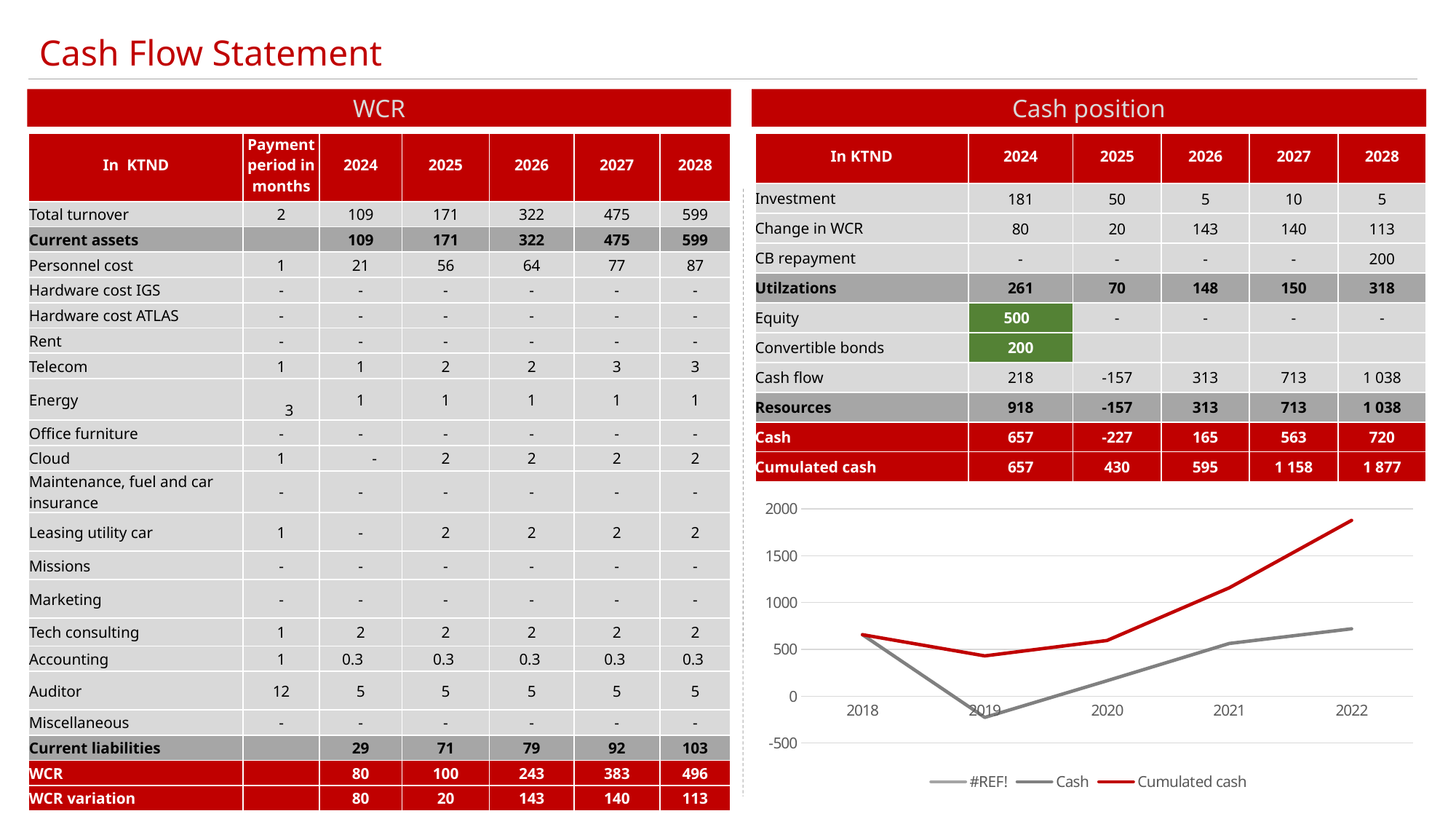
Which entries appear in the legend of the line chart? #REF!, Cash, Cumulated cash How many series does the legend of the line chart list? 3 In the line chart, is the Cumulated cash value for 2022 greater or less than 1500? greater In the line chart, is the Cash value for 2019 greater or less than 0? less In the line chart, does the Cash series rise or fall from 2018 to 2019? Fall What kind of chart is shown under the Cash position table? Line chart In the line chart, is the Cash value for 2022 greater or less than 500? greater How many years are shown on the x axis of the line chart? 5 In the line chart, which year has the highest Cumulated cash value? 2022 In the line chart, does the Cumulated cash series rise or fall from 2019 to 2022? Rise What colour is the Cumulated cash line in the chart? Red In the line chart, which year has the lowest Cash value? 2019